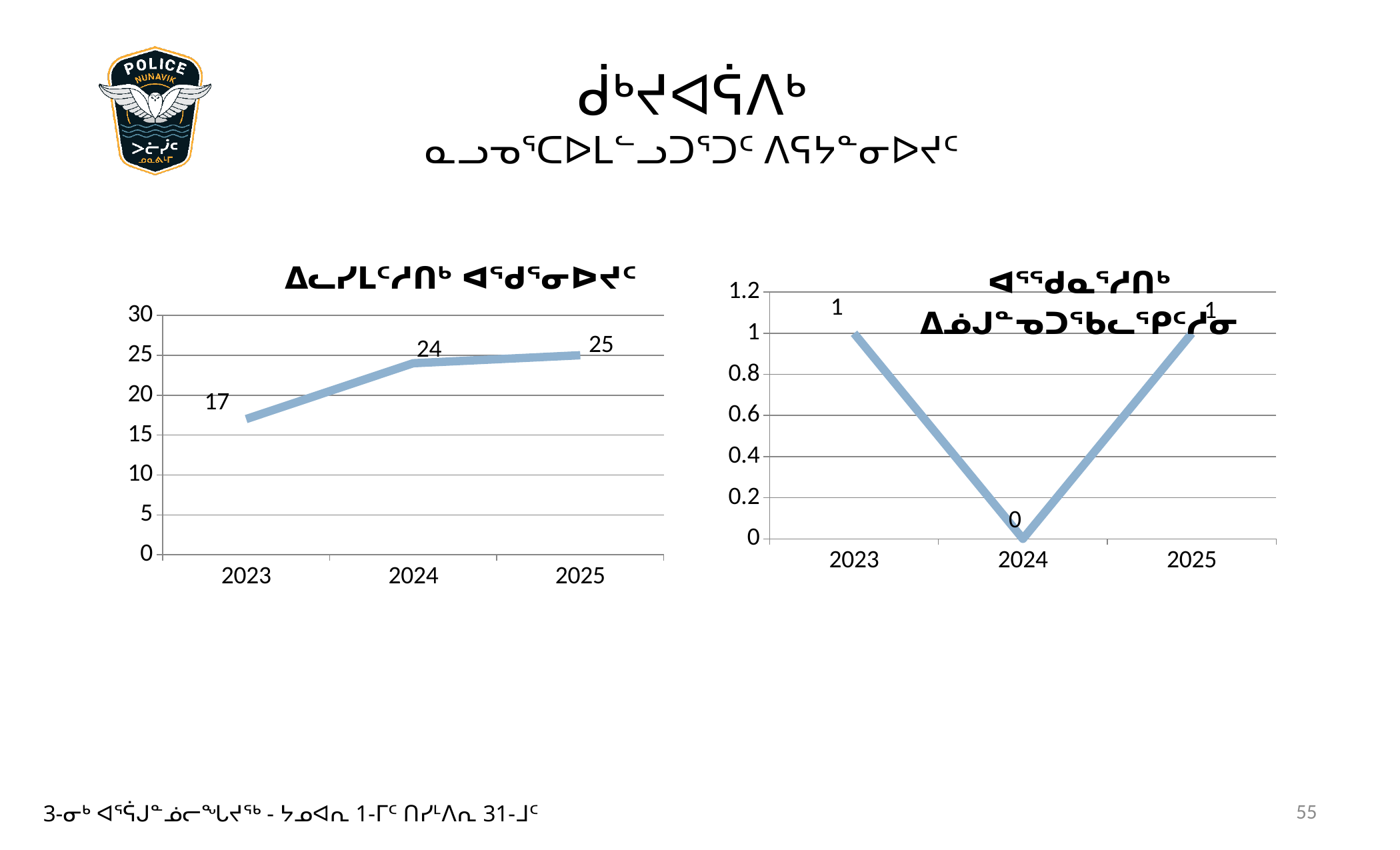
In the right chart, which year has the lowest value? 2024 In the left chart, is the value for 2023 greater or less than 20? less In the left chart, which year has the lowest value? 2023 In the left chart, what is the value for 2024? 24 In the left chart, what is the value for 2025? 25 What kind of chart is the left chart? line chart In the left chart, what is the value for 2023? 17 How many years are plotted on the x axis of the right chart? 3 In the left chart, do the values rise or fall from 2023 to 2025? rise In the right chart, what is the value for 2024? 0 In the left chart, what is the difference between the values for 2024 and 2023? 7 In the right chart, what is the value for 2023? 1